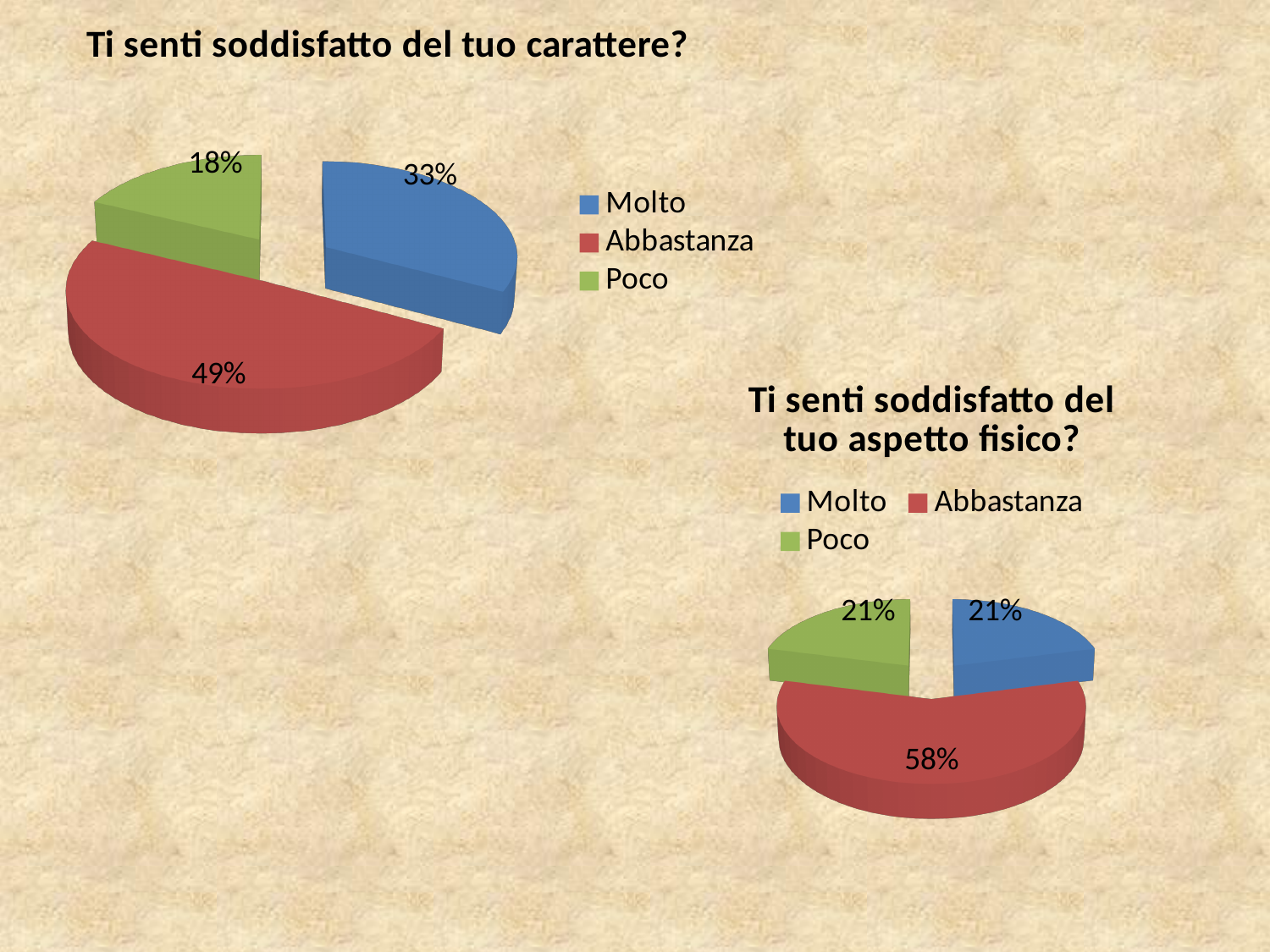
In the chart titled "Ti senti soddisfatto del tuo aspetto fisico?", what is the difference in percentage points between Abbastanza and Molto? 37 In the chart titled "Ti senti soddisfatto del tuo carattere?", what percentage is shown for Poco? 18% In the chart titled "Ti senti soddisfatto del tuo carattere?", what percentage is shown for Abbastanza? 49% How many categories does the legend of the chart titled "Ti senti soddisfatto del tuo aspetto fisico?" list? 3 What kind of chart is used for "Ti senti soddisfatto del tuo carattere?"? Pie chart In the chart titled "Ti senti soddisfatto del tuo aspetto fisico?", what percentage is shown for Poco? 21% In the chart titled "Ti senti soddisfatto del tuo aspetto fisico?", which category has the largest share? Abbastanza In the chart titled "Ti senti soddisfatto del tuo carattere?", what percentage is shown for Molto? 33% In the chart titled "Ti senti soddisfatto del tuo carattere?", which category has the smallest share? Poco In the chart titled "Ti senti soddisfatto del tuo carattere?", what is the difference in percentage points between Abbastanza and Molto? 16 In the chart titled "Ti senti soddisfatto del tuo aspetto fisico?", what percentage is shown for Abbastanza? 58% In the chart titled "Ti senti soddisfatto del tuo carattere?", which category has the largest share? Abbastanza